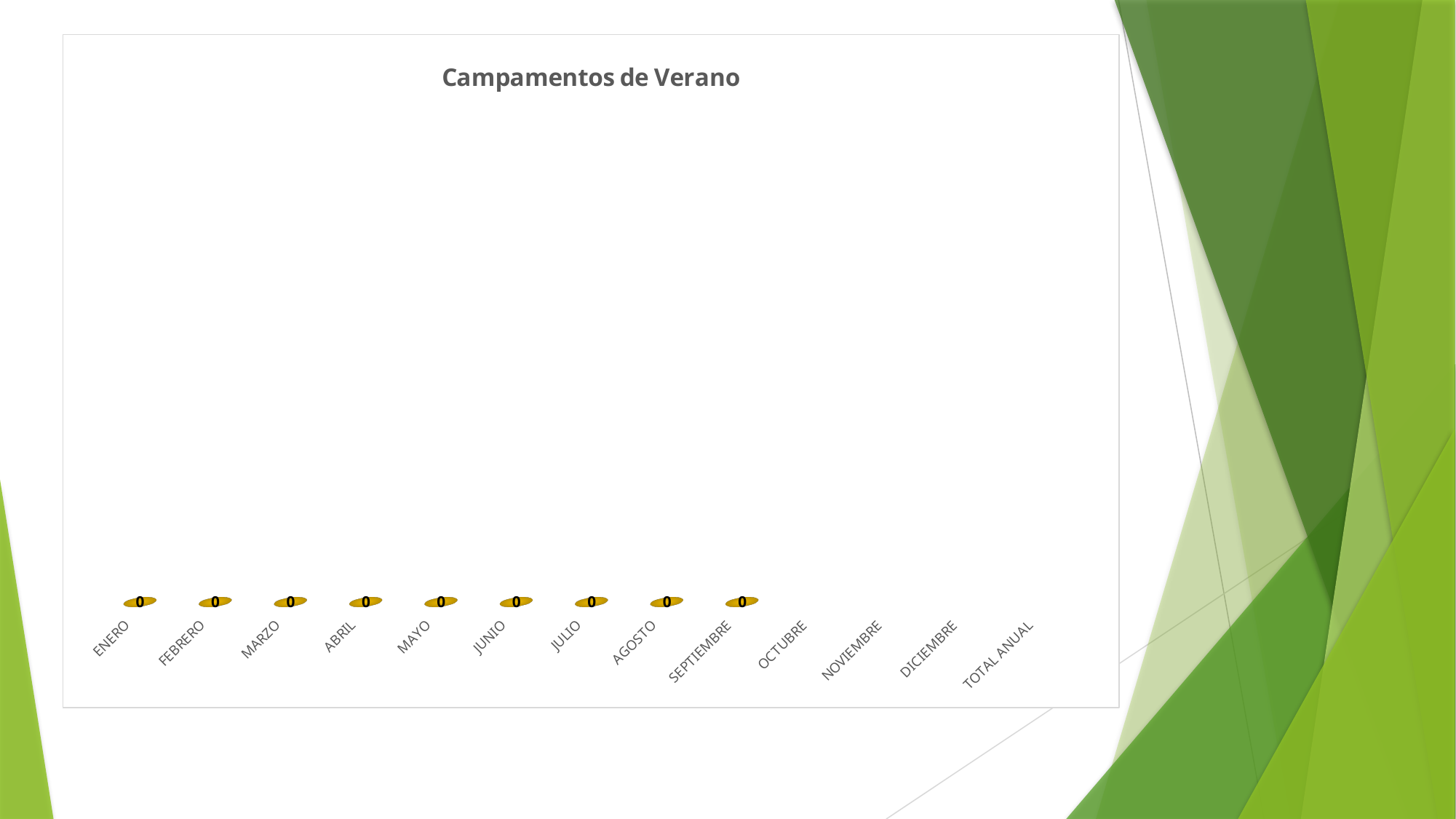
How many data points have a printed data label? 9 How many categories are listed along the x axis? 13 Do the values rise, fall, or stay the same from ENERO to SEPTIEMBRE? stay the same What kind of chart is shown on the slide? bar chart What is the value shown for MAYO? 0 What is the title of the chart? Campamentos de Verano What is the label of the last category on the x axis? TOTAL ANUAL What is the value shown for JULIO? 0 What is the value shown for ENERO? 0 What is the difference between the values for ENERO and AGOSTO? 0 What is the value shown for SEPTIEMBRE? 0